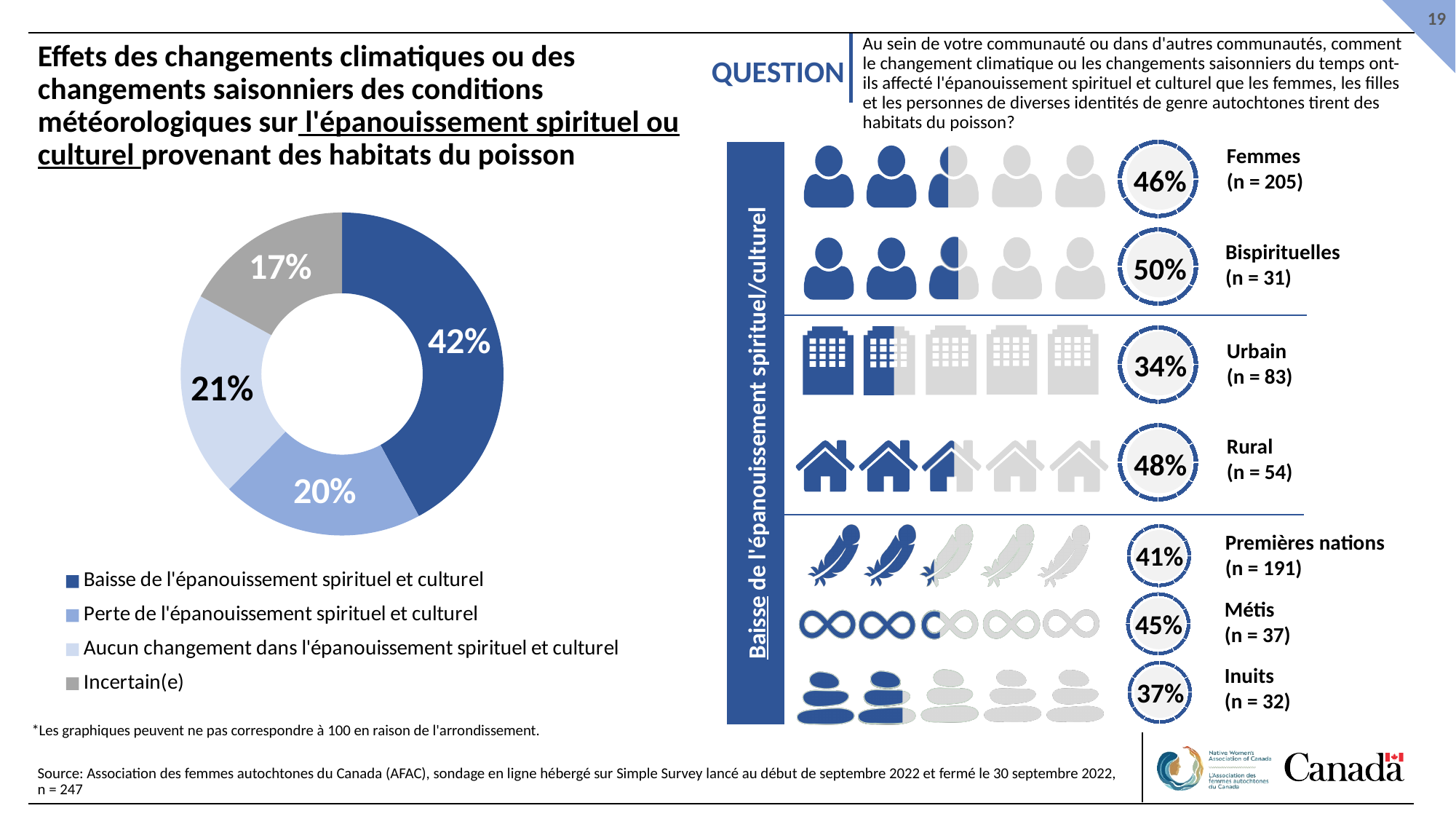
In the donut chart, what percentage corresponds to "Aucun changement dans l'épanouissement spirituel et culturel"? 21% In the infographic on the right, which group has the highest percentage reporting a decrease in spiritual/cultural fulfilment? Bispirituelles (50%) In the infographic on the right, which group has the lowest percentage? Urbain (34%) In the donut chart, which category has the largest share? Baisse de l'épanouissement spirituel et culturel What kind of chart is shown on the left side of the slide? Donut (pie) chart In the donut chart, what is the difference in percentage points between "Baisse de l'épanouissement spirituel et culturel" and "Perte de l'épanouissement spirituel et culturel"? 22 percentage points How many categories does the legend of the donut chart list? 4 In the donut chart, what percentage corresponds to "Baisse de l'épanouissement spirituel et culturel"? 42% In the donut chart, which category has the smallest share? Incertain(e) In the infographic on the right, which is larger: the percentage for "Premières nations" or for "Métis"? Métis (45%) In the infographic on the right, what percentage is shown for "Rural (n = 54)"? 48% In the donut chart, what percentage corresponds to "Incertain(e)"? 17%